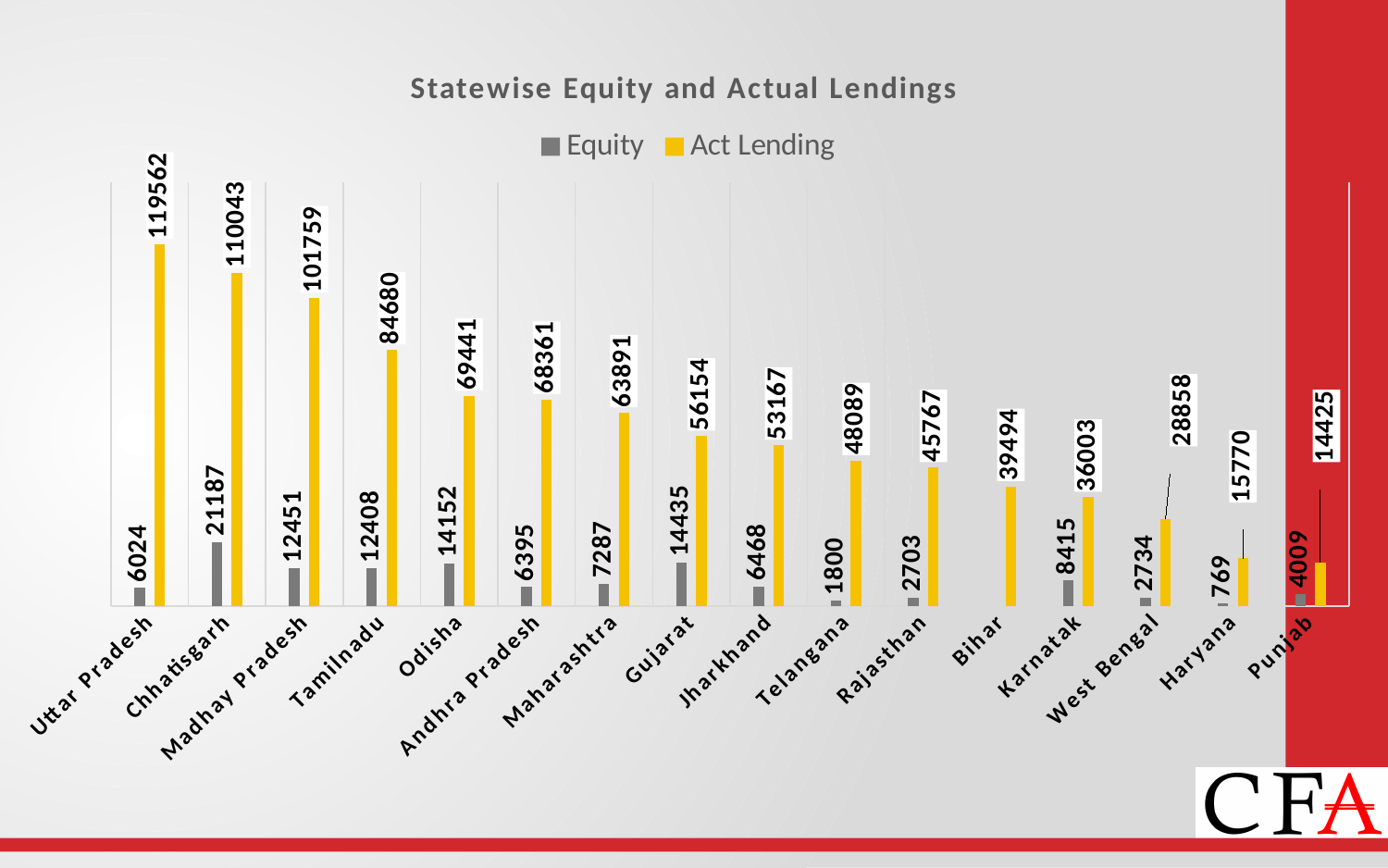
How many series does the legend list? 2 Which state has the highest Equity value? Chhatisgarh What is the Equity value for Chhatisgarh? 21187 What is the Act Lending value for West Bengal? 28858 What is the Act Lending value for Tamilnadu? 84680 How many states are shown on the x axis? 16 Which state has the lowest Act Lending value? Punjab Which state has the lowest labelled Equity value? Haryana Which is larger, the Equity value for Gujarat or for Odisha? Gujarat What is the difference between the Act Lending values of Uttar Pradesh and Chhatisgarh? 9519 Do the Act Lending values rise or fall from left to right along the x axis? fall Which state has the highest Act Lending value? Uttar Pradesh